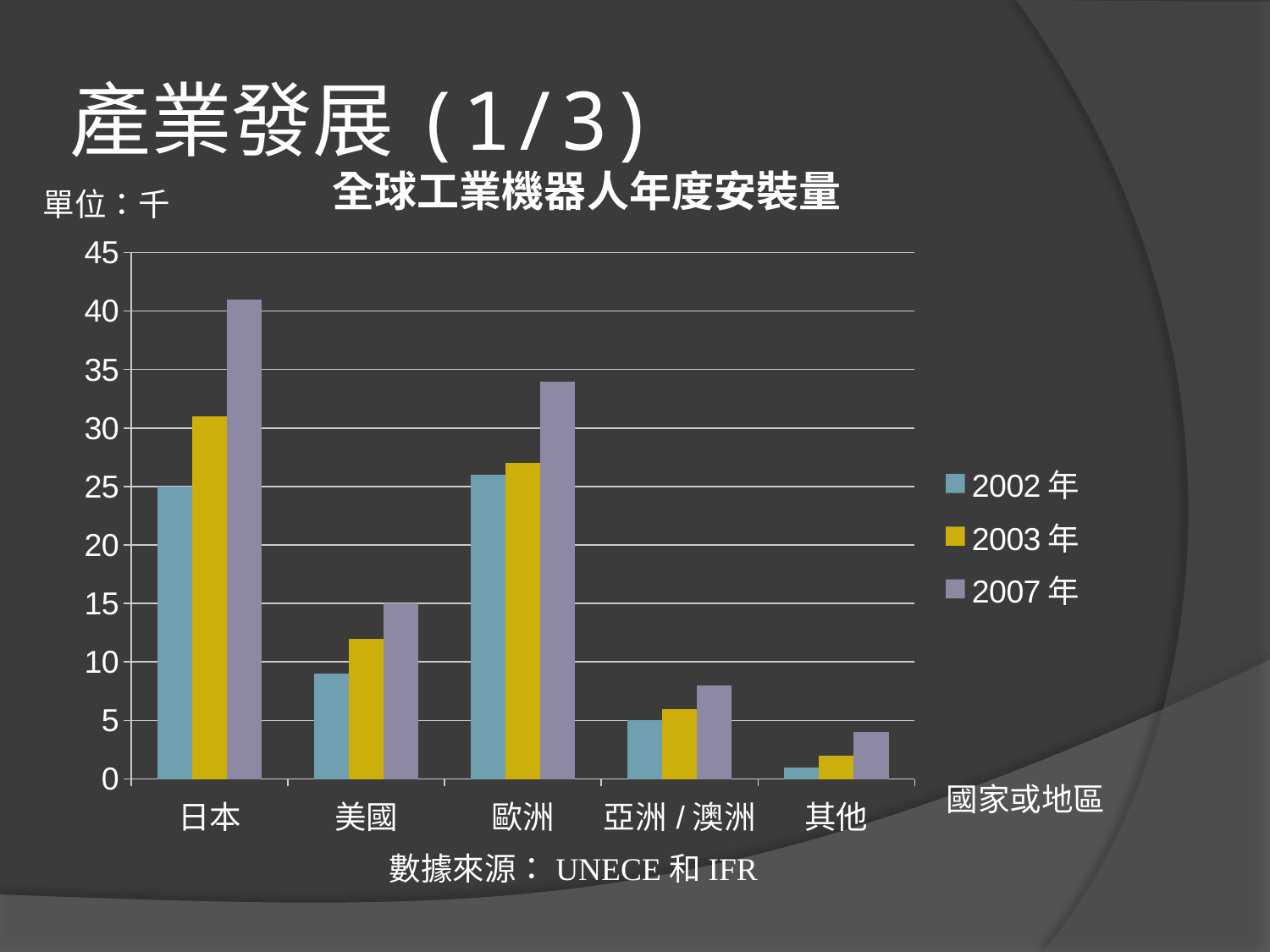
Which country or region has the lowest value in 2003 年? 其他 What is the value for 亞洲 / 澳洲 in 2002 年? 5 Is the value for 日本 in 2007 年 greater or less than 40? greater What kind of chart is shown on the slide? bar chart Is the value for 歐洲 in 2003 年 greater or less than 30? less What is the title of the chart? 全球工業機器人年度安裝量 Which country or region has the highest value in 2007 年? 日本 How many series does the legend list? 3 What is the value for 美國 in 2007 年? 15 What is the value for 日本 in 2002 年? 25 How many countries or regions are shown on the x axis? 5 Which is larger for 歐洲: the 2002 年 value or the 2007 年 value? 2007 年